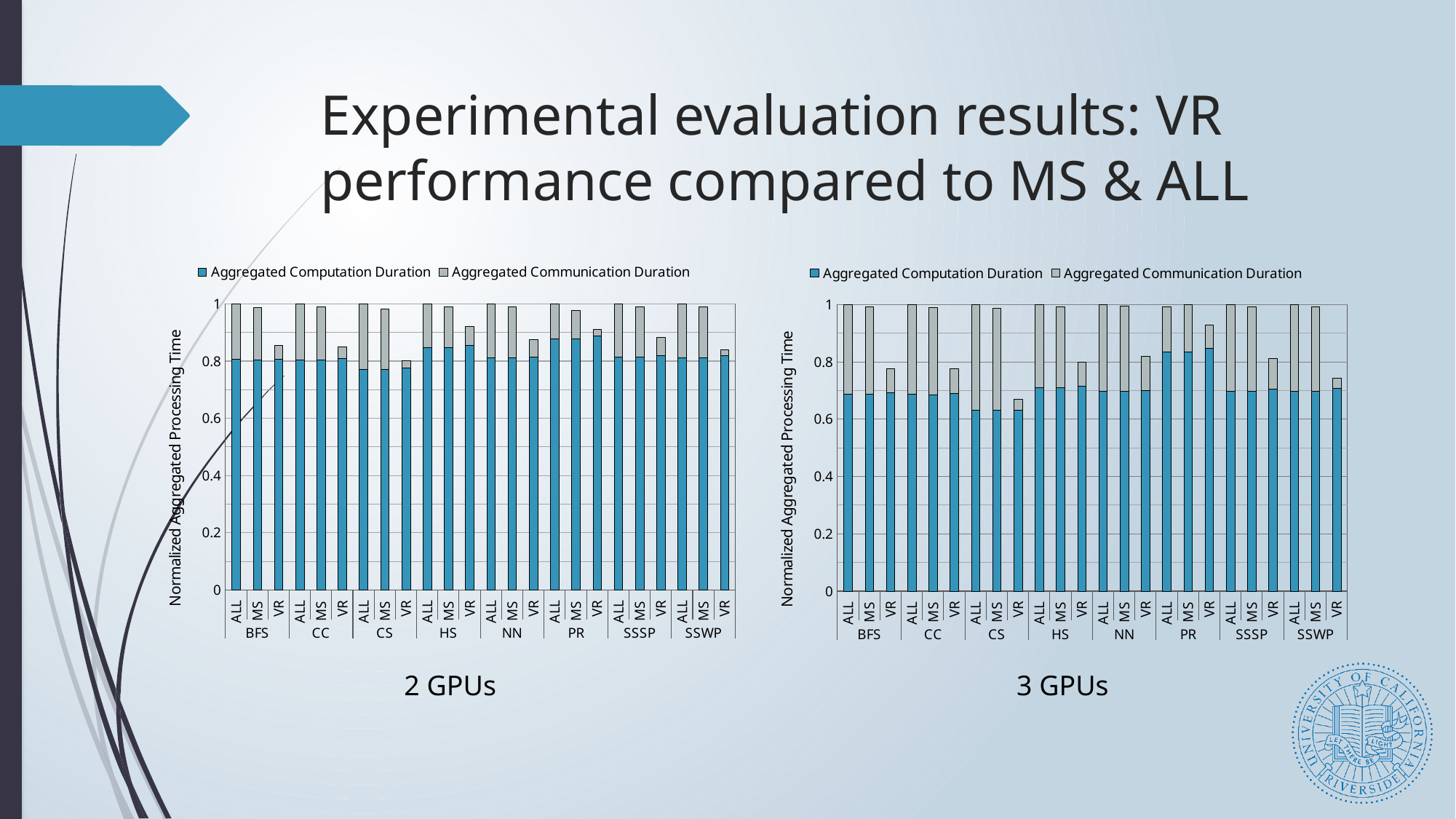
In the 2 GPUs chart, how many algorithm groups are shown on the x axis? 8 In the 3 GPUs chart, which algorithm group has the lowest total stacked bar for VR? CS In the 2 GPUs chart, is the total stacked bar for VR under PR greater or less than 0.8? greater In the 2 GPUs chart, what is the total height of the stacked bar for ALL under BFS? 1 In the 3 GPUs chart, is the total stacked bar for VR under CS greater or less than 0.8? less In the 3 GPUs chart, which is taller in total: the MS bar or the VR bar under BFS? MS What kind of chart is the 2 GPUs chart? stacked bar chart In the 3 GPUs chart, how many bars are shown for each algorithm group? 3 In the 3 GPUs chart, is the Aggregated Computation Duration for MS under CS greater or less than 0.8? less How many series does the legend of the 3 GPUs chart list? 2 What is the y-axis title of the 2 GPUs chart? Normalized Aggregated Processing Time